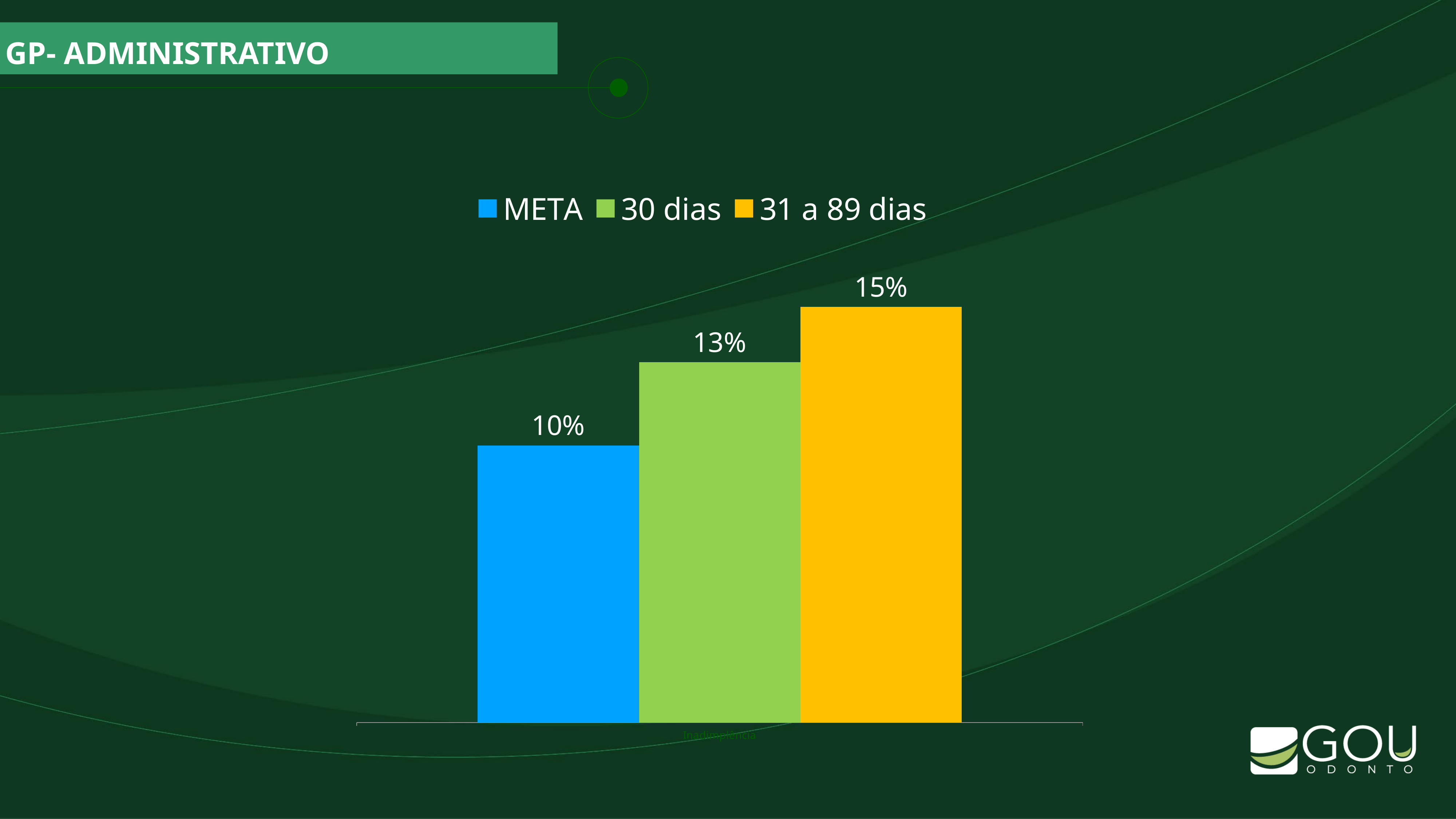
Which is larger, the value for 30 dias or the value for 31 a 89 dias? 31 a 89 dias What is the value for 31 a 89 dias? 15% What is the difference between the values for 31 a 89 dias and META? 5% Which series has the lowest value? META What is the value for META? 10% Do the values rise or fall from left to right across the bars? rise Which series has the highest value? 31 a 89 dias What kind of chart is shown on the slide? bar chart How many series does the legend list? 3 What colour is the bar for 31 a 89 dias? yellow What is the difference between the values for 30 dias and META? 3% What is the value for 30 dias? 13%